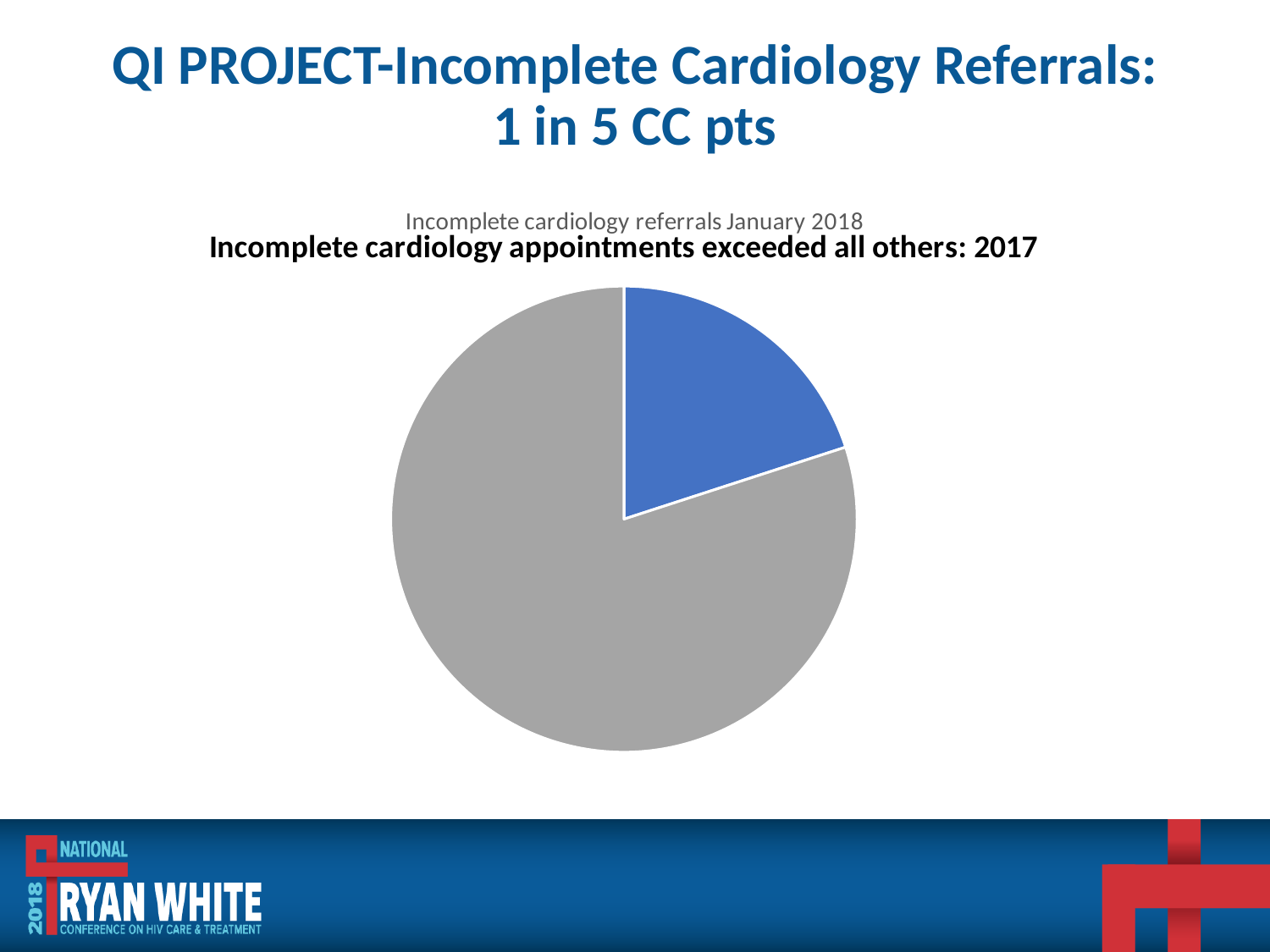
What is the title of the pie chart? Incomplete cardiology appointments exceeded all others: 2017 How many slices does the pie chart have? 2 What kind of chart is shown on the slide? pie chart Which slice of the pie chart is the smallest? the blue slice Which slice of the pie chart is the largest? the gray slice Which slice of the pie chart is larger, the blue slice or the gray slice? the gray slice What two colours are used for the slices of the pie chart? blue and gray